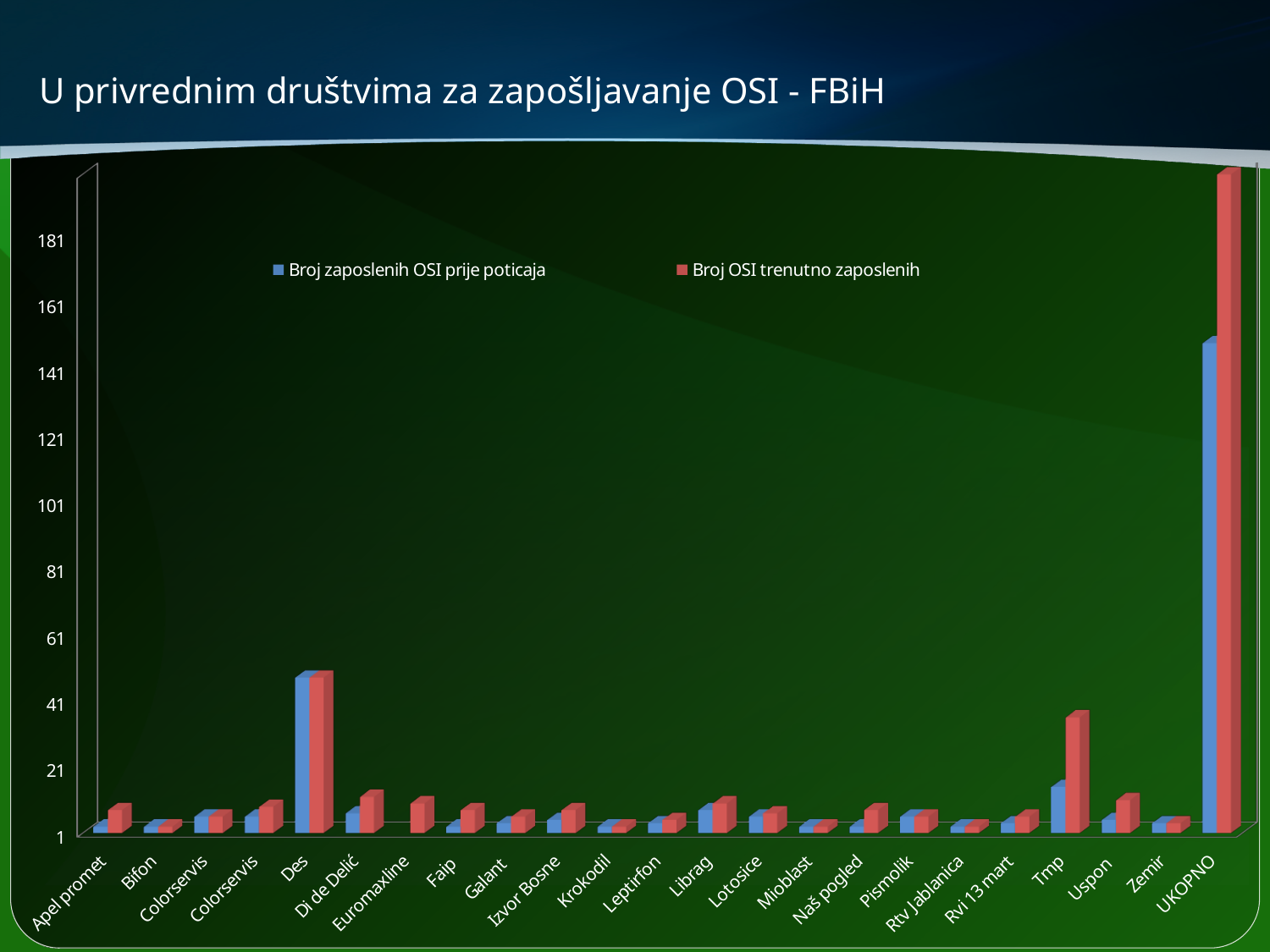
What kind of chart is shown on the slide? bar chart How many series does the legend list? 2 For Tmp, which series has the larger value: Broj zaposlenih OSI prije poticaja or Broj OSI trenutno zaposlenih? Broj OSI trenutno zaposlenih Which category has the highest value for Broj OSI trenutno zaposlenih? UKOPNO Is the value for Des in the Broj zaposlenih OSI prije poticaja series greater or less than 41? greater In the Broj OSI trenutno zaposlenih series, which is larger: Des or Tmp? Des Which category has the highest value for Broj zaposlenih OSI prije poticaja? UKOPNO What is the title of the slide? U privrednim društvima za zapošljavanje OSI - FBiH Is the value for Tmp in the Broj OSI trenutno zaposlenih series greater or less than 41? less How many categories are shown along the x axis? 23 Is the value for UKOPNO in the Broj zaposlenih OSI prije poticaja series greater or less than 141? greater